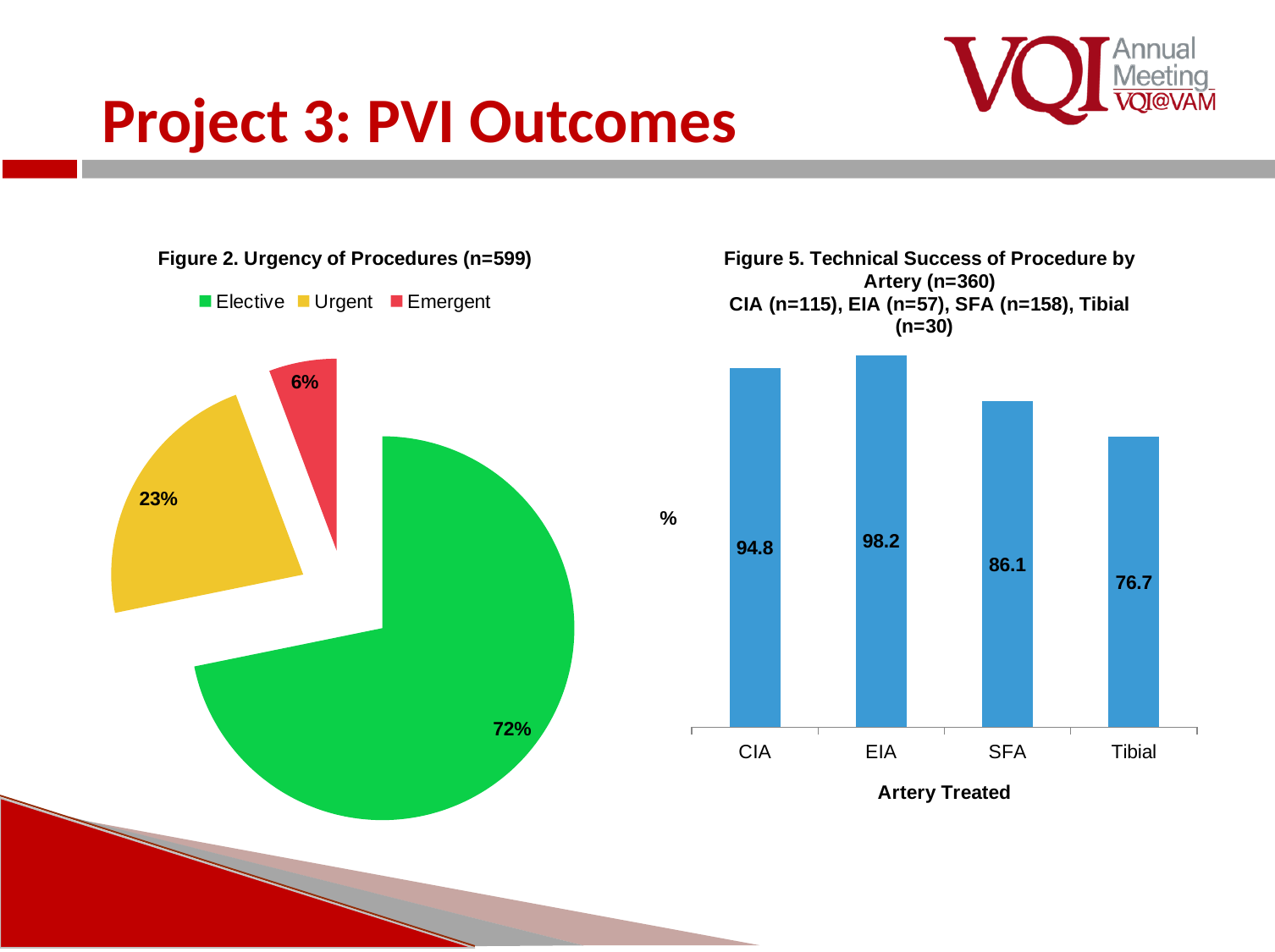
In the Figure 2 pie chart, what share of procedures is Emergent? 6% In the Figure 2 pie chart, which category has the smallest slice? Emergent What type of chart is Figure 5? Bar chart In the Figure 2 pie chart, what share of procedures is Urgent? 23% In the Figure 5 chart, what is the difference between the values for CIA and SFA? 8.7 In the Figure 5 chart, which artery has the highest technical success? EIA In the Figure 2 pie chart, how many categories does the legend list? 3 In the Figure 2 pie chart, what share of procedures is Elective? 72% In the Figure 5 chart, what is the technical success value for Tibial? 76.7 What type of chart is Figure 2? Pie chart In the Figure 5 chart, which is larger, the value for CIA or the value for Tibial? CIA In the Figure 5 chart, what is the technical success value for EIA? 98.2